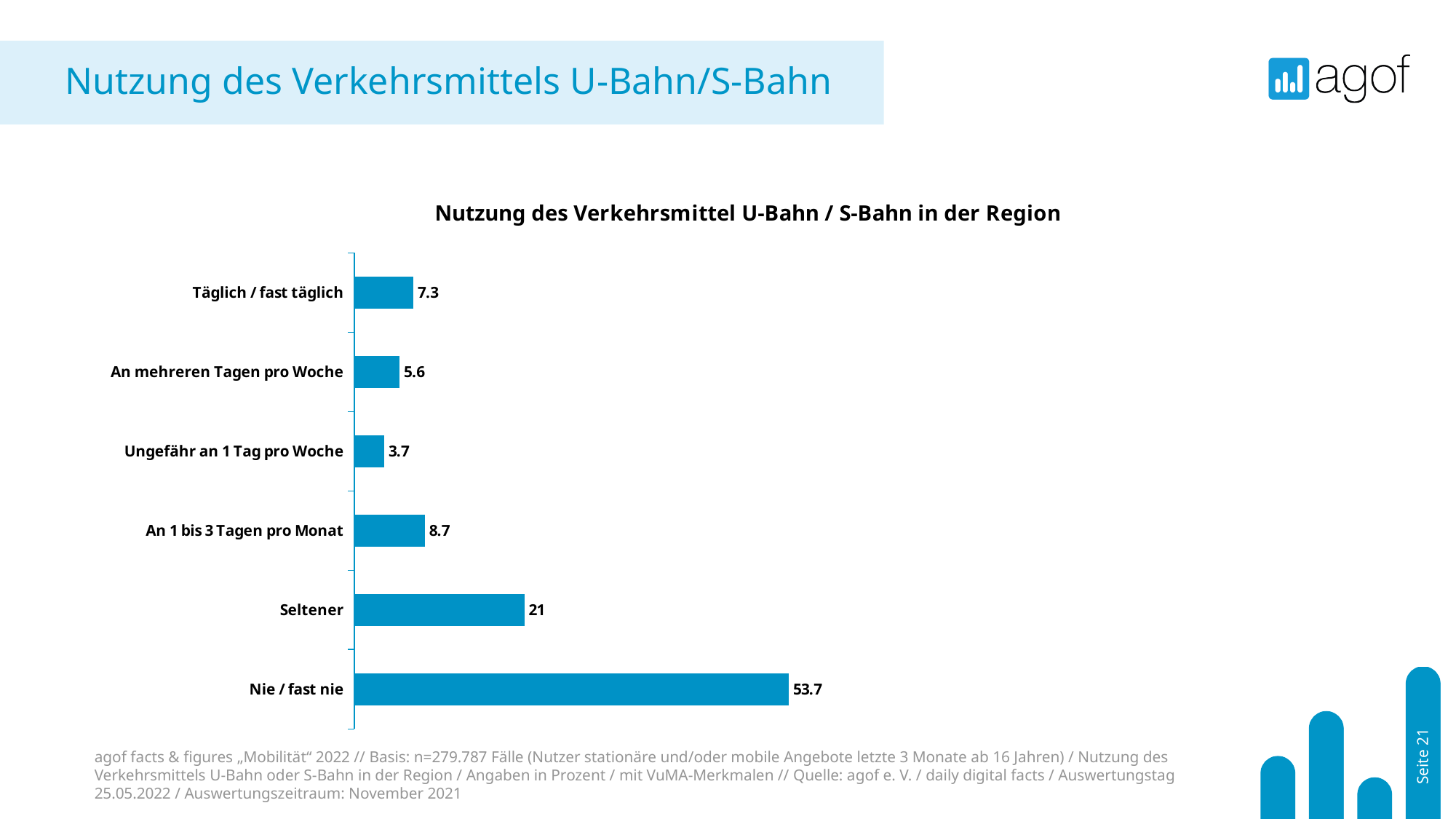
Which category has the highest value? Nie / fast nie How many categories are shown in the chart? 6 Which is larger, the value for "Täglich / fast täglich" or the value for "An 1 bis 3 Tagen pro Monat"? An 1 bis 3 Tagen pro Monat What is the difference between the values for "Nie / fast nie" and "Seltener"? 32.7 What is the title of the chart? Nutzung des Verkehrsmittel U-Bahn / S-Bahn in der Region What is the value for "Ungefähr an 1 Tag pro Woche"? 3.7 What is the value for "Nie / fast nie"? 53.7 What is the difference between the values for "An 1 bis 3 Tagen pro Monat" and "An mehreren Tagen pro Woche"? 3.1 What kind of chart is shown on the slide? Bar chart What is the value for "Täglich / fast täglich"? 7.3 What is the value for "Seltener"? 21 Which category has the lowest value? Ungefähr an 1 Tag pro Woche